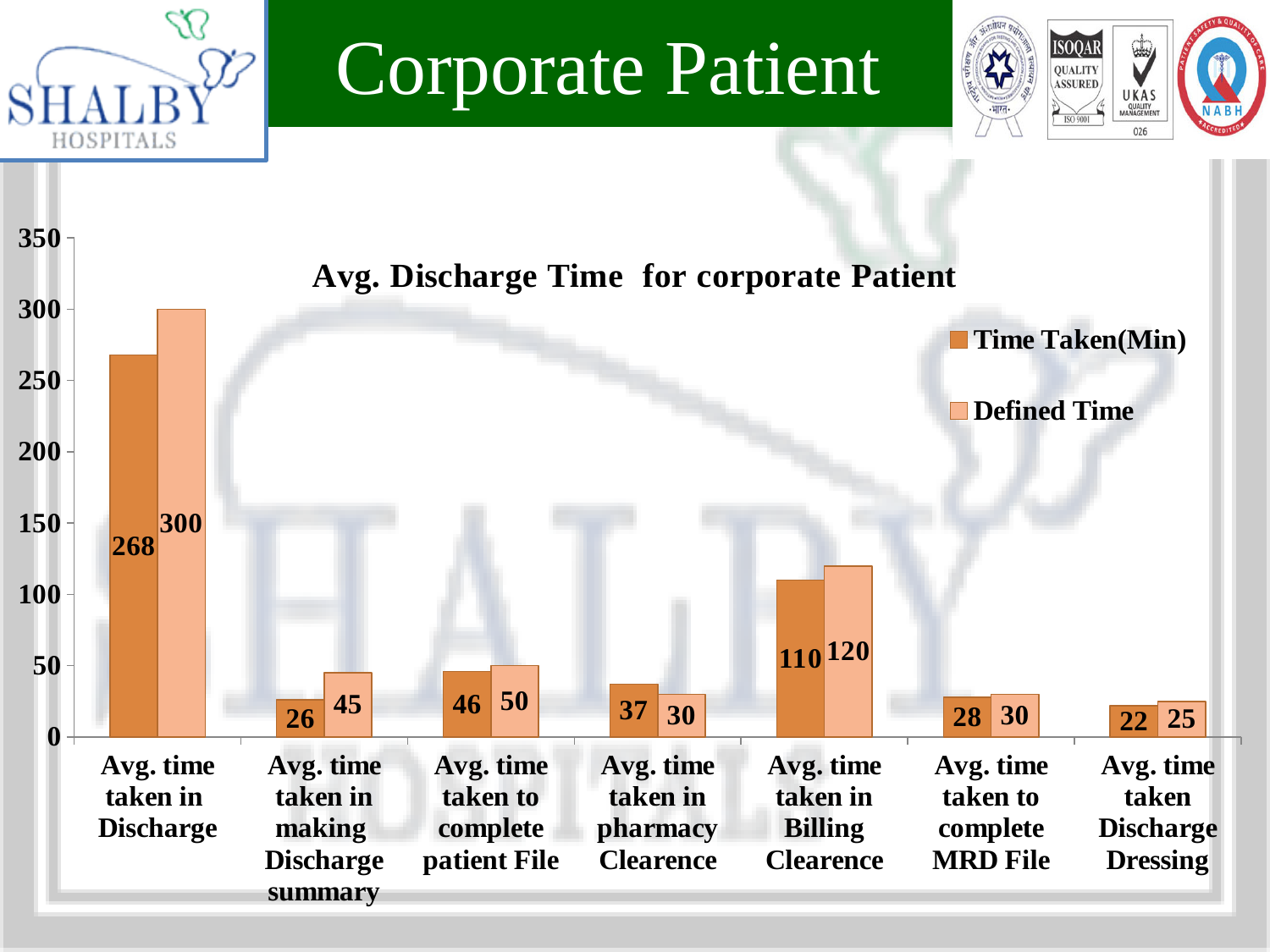
Which category has the highest Time Taken(Min) value? Avg. time taken in Discharge Is the Time Taken(Min) value for Avg. time taken in Billing Clearence greater or less than 100? greater What is the title of the chart? Avg. Discharge Time for corporate Patient Which category has the lowest Defined Time value? Avg. time taken Discharge Dressing What is the Time Taken(Min) value for Avg. time taken in pharmacy Clearence? 37 What is the Defined Time value for Avg. time taken in Billing Clearence? 120 What kind of chart is shown on the slide? Bar chart What is the Time Taken(Min) value for Avg. time taken in Discharge? 268 How many categories are shown on the x axis of the chart? 7 For Avg. time taken in pharmacy Clearence, which is larger: Time Taken(Min) or Defined Time? Time Taken(Min) How many series does the chart legend list? 2 What is the difference between the Defined Time and the Time Taken(Min) for Avg. time taken in making Discharge summary? 19